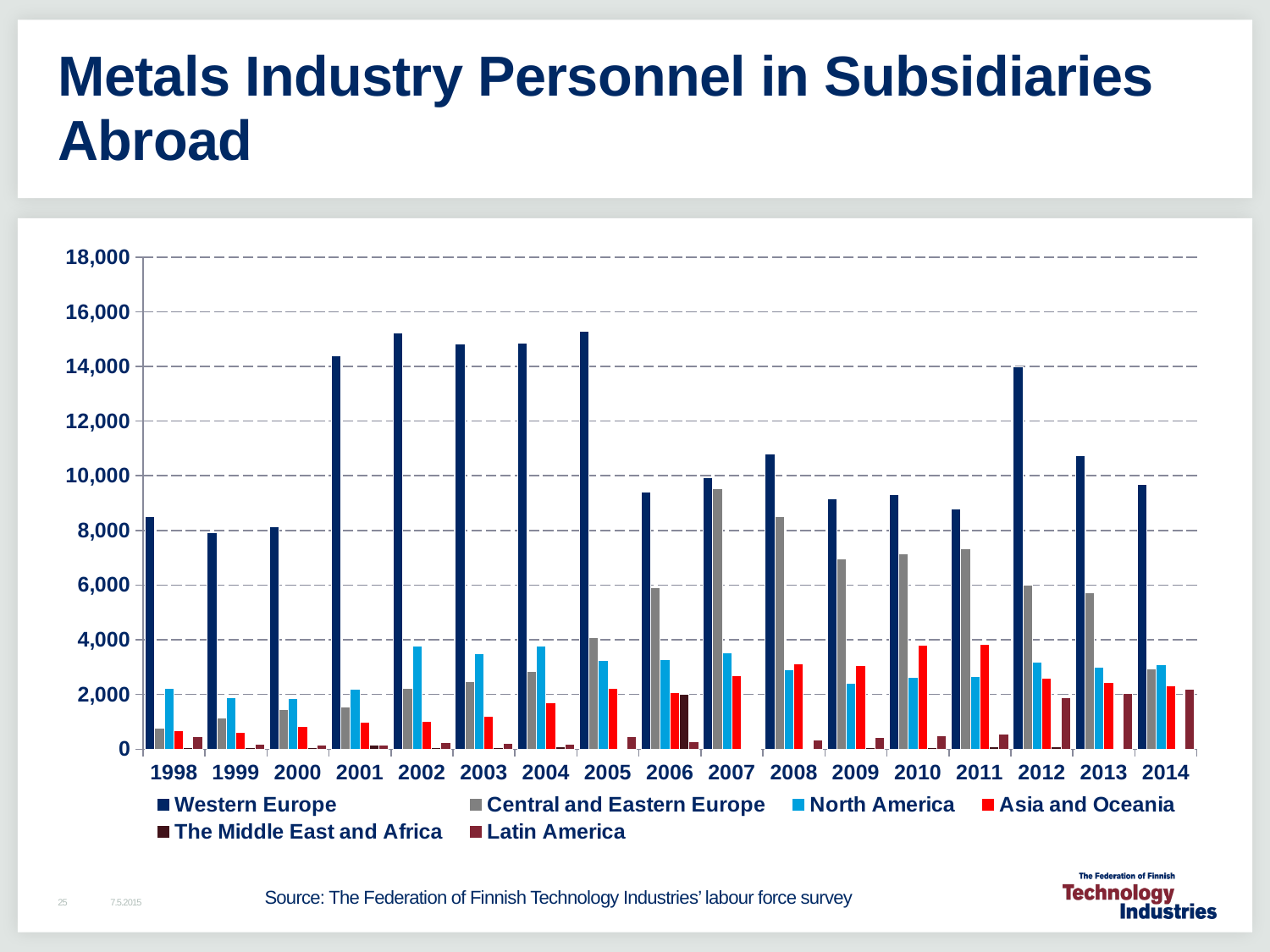
Is the value for Western Europe in 1998 greater or less than 10,000? less Does the Central and Eastern Europe value rise or fall from 1998 to 2007? rise Is the value for Central and Eastern Europe in 2007 greater or less than 8,000? greater In which year is the Central and Eastern Europe value lowest? 1998 How many years are shown on the x axis? 17 In 2008, which is larger: Western Europe or Central and Eastern Europe? Western Europe In 2010, which is larger: Asia and Oceania or North America? Asia and Oceania In which year is the Central and Eastern Europe value highest? 2007 How many series does the legend list? 6 What kind of chart is shown on the slide? bar chart Is the value for North America in 2002 greater or less than 2,000? greater